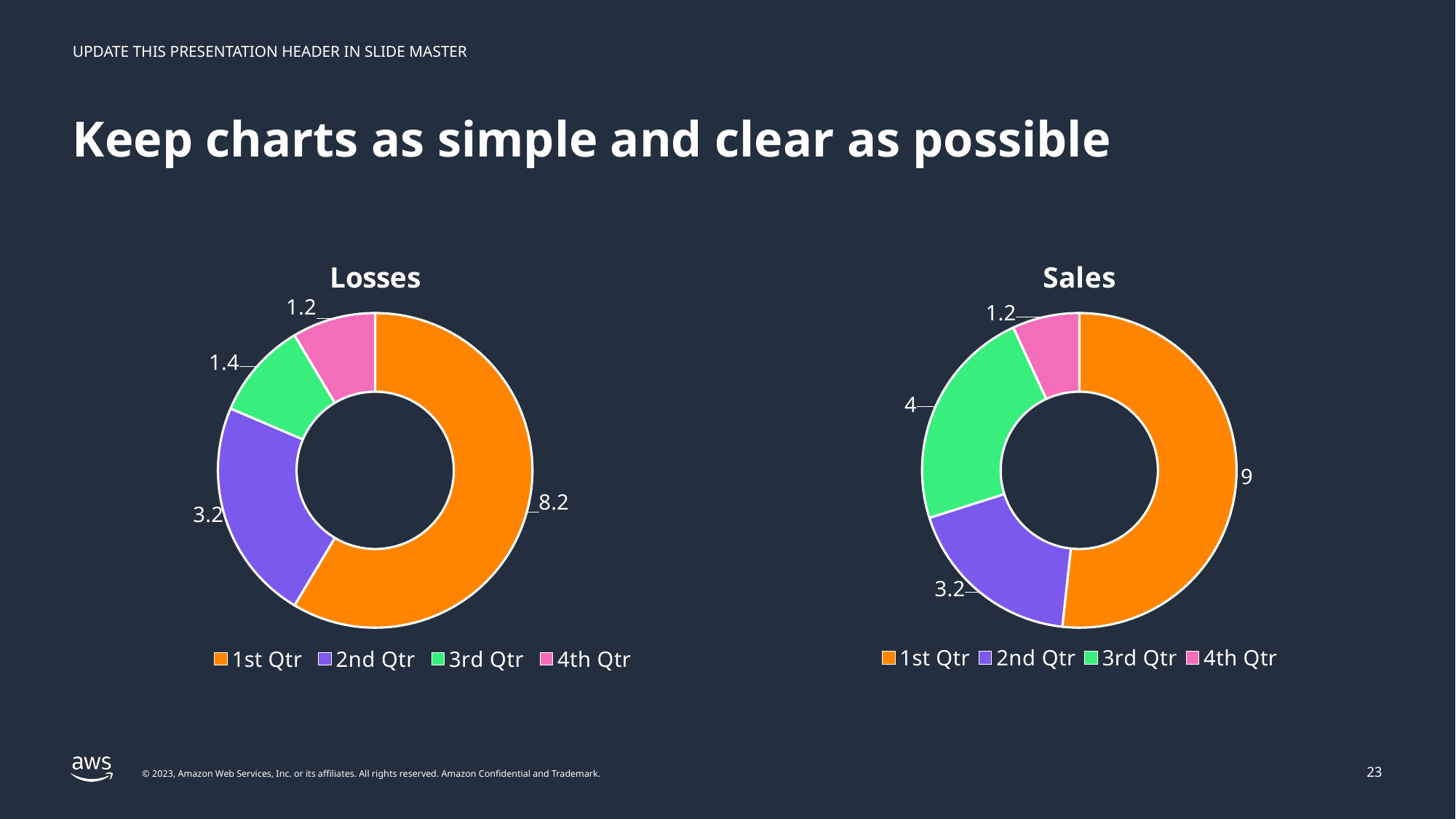
In the Sales chart, which quarter has the largest slice? 1st Qtr In the Losses chart, what is the value for 1st Qtr? 8.2 What kind of chart is the Sales chart? doughnut chart What colour represents 2nd Qtr in the legend of the Losses chart? purple In the Sales chart, what is the difference between the 1st Qtr and 2nd Qtr values? 5.8 How many slices does the Losses chart have? 4 In the Losses chart, what is the difference between the 2nd Qtr and 3rd Qtr values? 1.8 In the Losses chart, which quarter has the smallest slice? 4th Qtr In the Sales chart, which is larger, 2nd Qtr or 3rd Qtr? 3rd Qtr In the Losses chart, what is the value for 3rd Qtr? 1.4 In the Sales chart, what is the value for 3rd Qtr? 4 What is the total of all slices in the Losses chart? 14